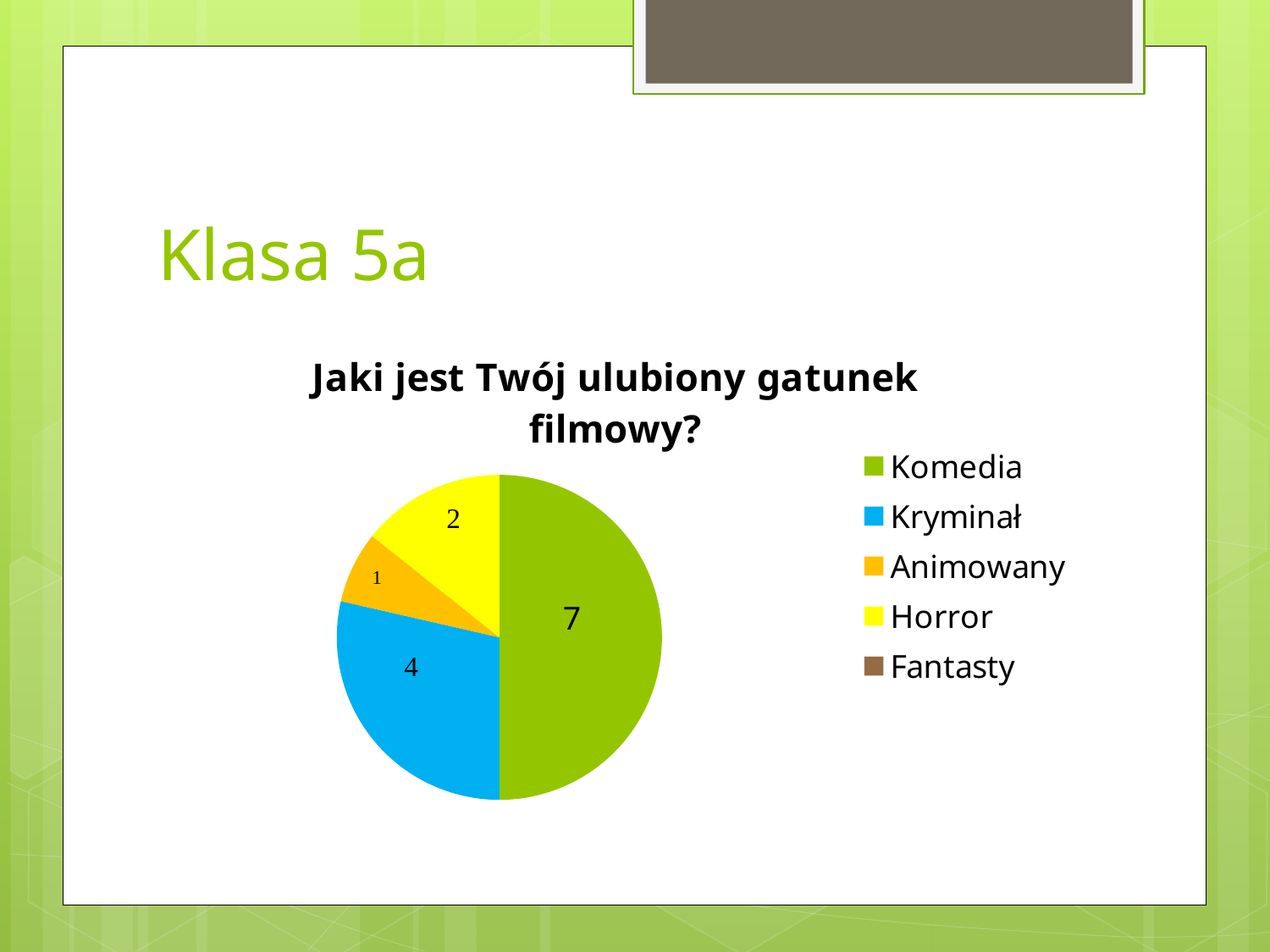
What is the value for Kryminał? 4 What is the value for Horror? 2 Which category has the largest slice of the pie? Komedia What type of chart is shown on the slide? pie chart Which colour represents Kryminał in the chart? blue What is the value for Animowany? 1 What is the value for Komedia? 7 What is the title of the chart? Jaki jest Twój ulubiony gatunek filmowy? Which is larger, the value for Kryminał or the value for Horror? Kryminał What is the difference between the values for Komedia and Kryminał? 3 How many categories does the legend list? 5 What is the difference between the values for Horror and Animowany? 1